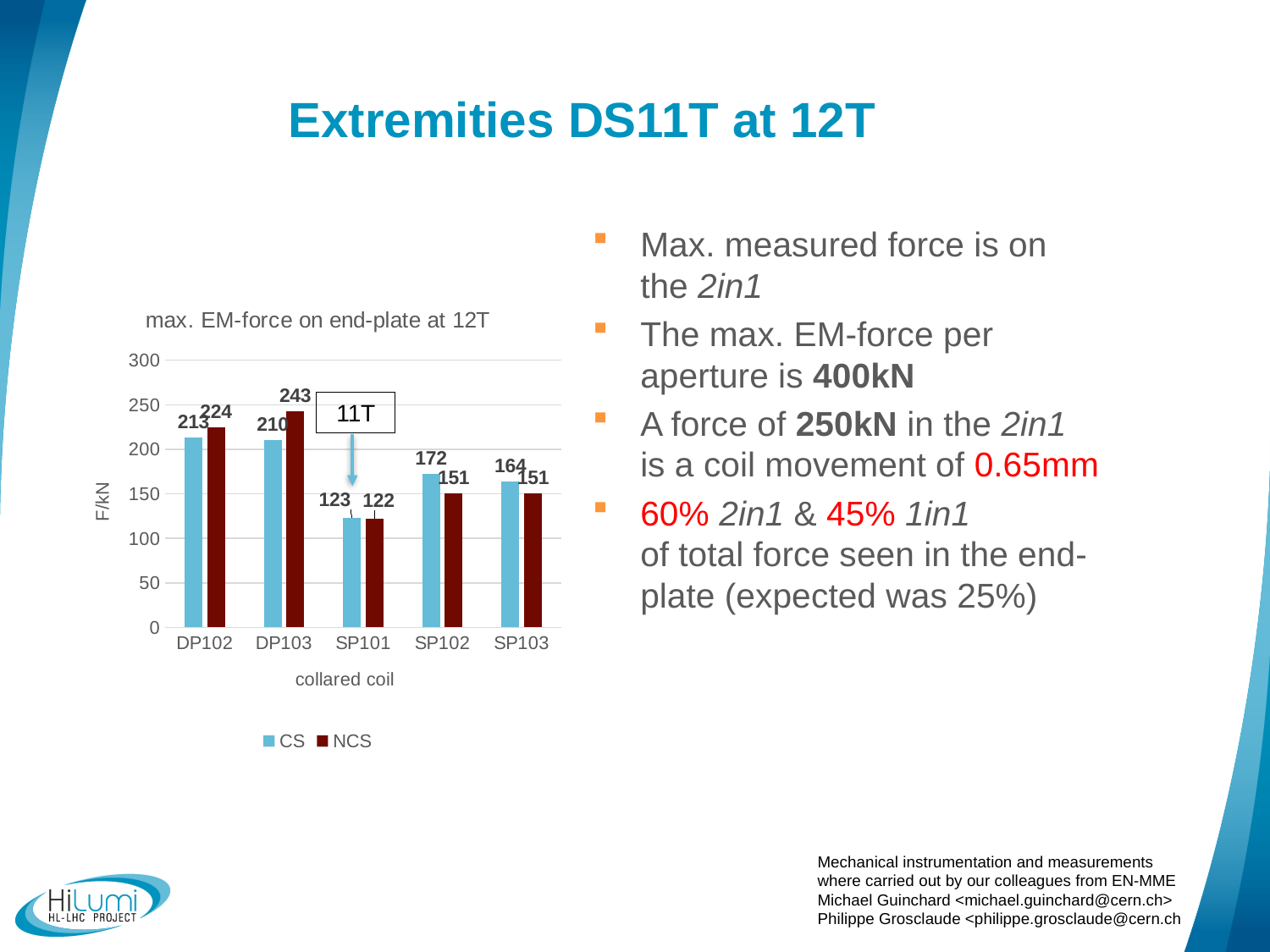
What is the NCS value for DP103? 243 What kind of chart is shown? bar chart What is the difference between the NCS and CS values for DP103? 33 How many collared coils are shown on the x axis? 5 What is the CS value for DP102? 213 Which is larger for SP102, the CS value or the NCS value? CS What is the CS value for SP102? 172 How many series does the legend list? 2 What is the title of the chart? max. EM-force on end-plate at 12T What is the NCS value for SP101? 122 Which collared coil has the highest NCS value? DP103 Which collared coil has the lowest CS value? SP101